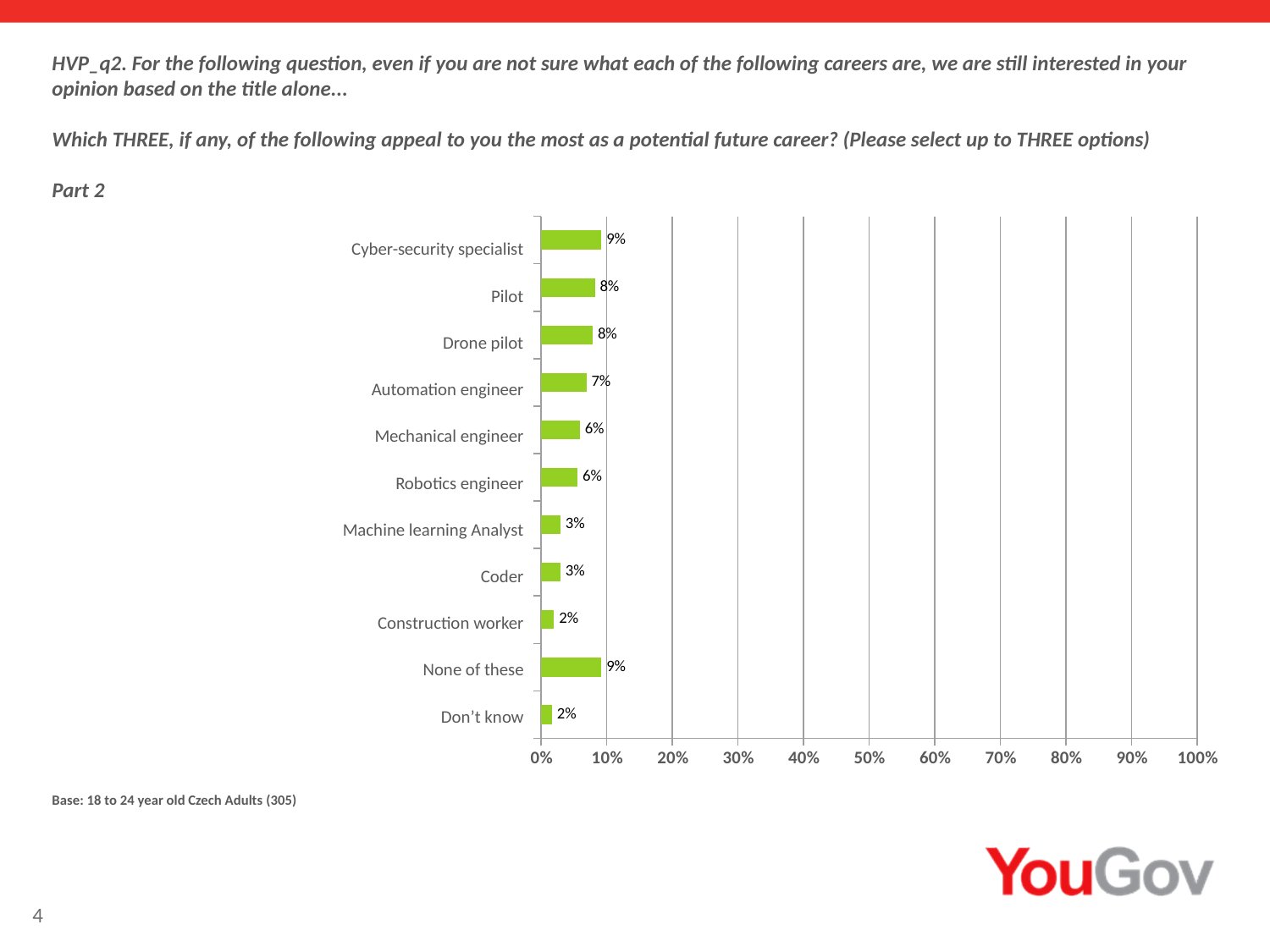
Which has a higher value, Mechanical engineer or Machine learning Analyst? Mechanical engineer What percentage of respondents selected Cyber-security specialist? 9% Which has a higher value, Drone pilot or Robotics engineer? Drone pilot What is the value for None of these? 9% What is the difference between the values for Pilot and Coder? 5% What is the value shown for Automation engineer? 7% What percentage of respondents answered Don't know? 2% What kind of chart is shown on the slide? Bar chart Is the value for Cyber-security specialist greater or less than 10%? less How many categories are shown on the chart? 11 What is the difference between the values for Cyber-security specialist and Construction worker? 7% What percentage is shown for Machine learning Analyst? 3%